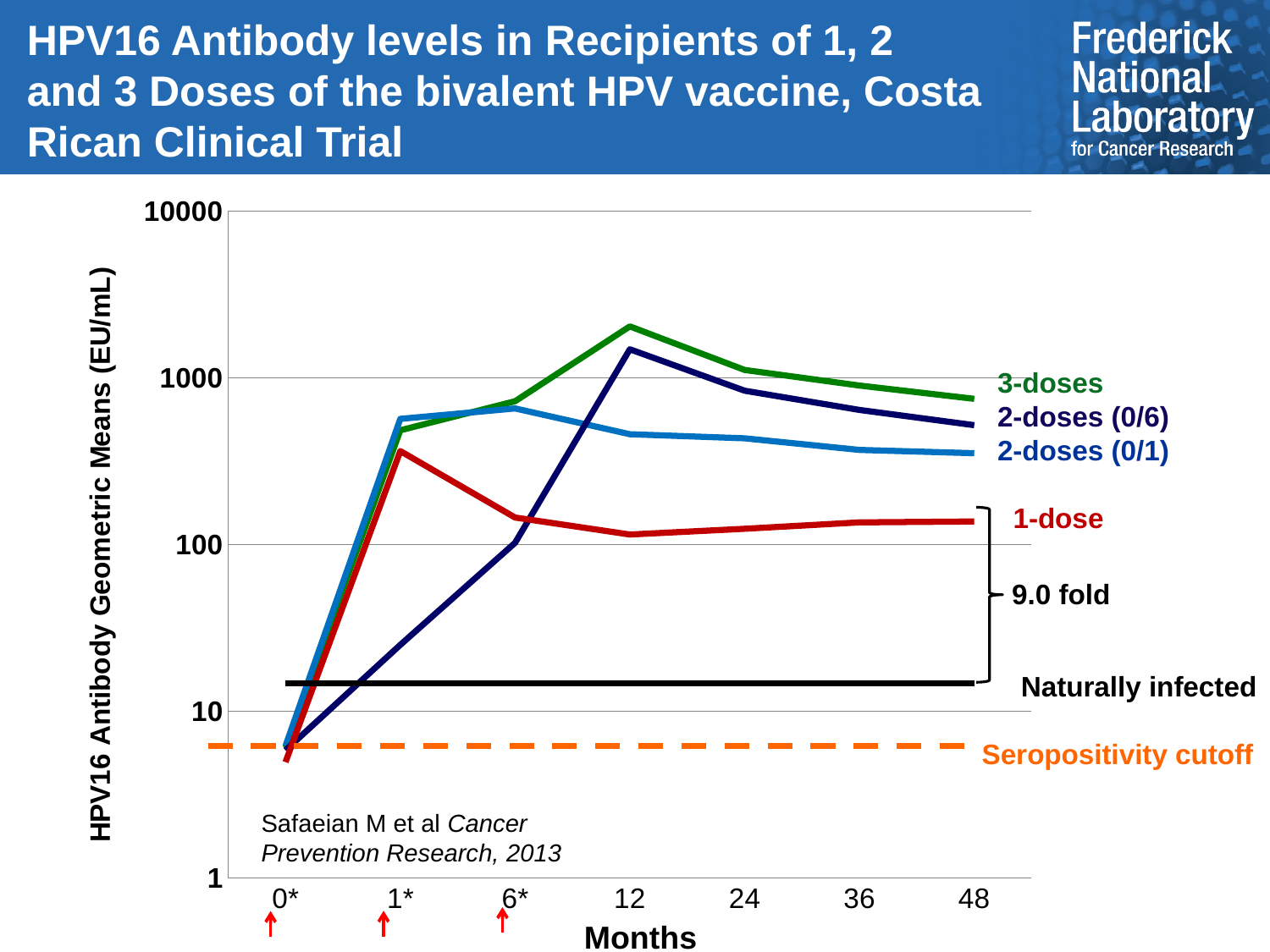
Is the value for 2-doses (0/6) at month 1* greater or less than 100 EU/mL? less Which dose group has the lowest HPV16 antibody level at 48 months? 1-dose Is the value for 3-doses at 12 months greater or less than 1000 EU/mL? greater How many vaccine dose groups are plotted as lines on the chart? 4 How many time points are labelled on the Months axis? 7 At month 1*, which is larger: the value for 2-doses (0/1) or the value for 2-doses (0/6)? 2-doses (0/1) Does the 1-dose line rise or fall between month 1* and month 12? fall What fold difference is annotated between the 1-dose line and the Naturally infected line? 9.0 fold What is the label of the y-axis? HPV16 Antibody Geometric Means (EU/mL) What kind of chart is shown on the slide? line chart Which dose group has the highest HPV16 antibody level at 12 months? 3-doses Is the value for 1-dose at month 1* greater or less than 100 EU/mL? greater